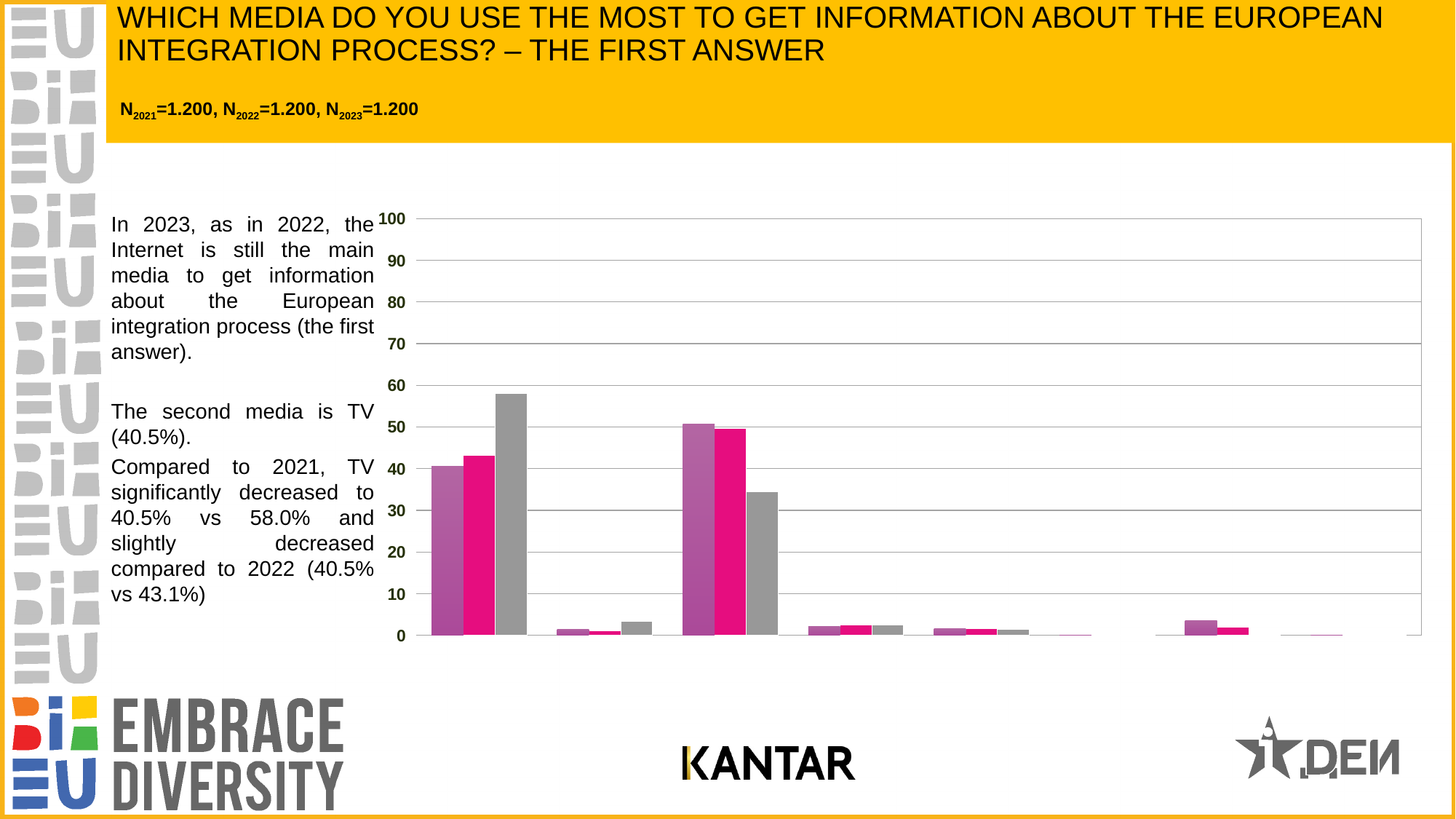
Which is taller: the grey bar in the first group or the grey bar in the third group? the grey bar in the first group In the third group of bars, is the grey bar greater or less than 40? less What kind of chart is shown on the slide? bar chart What is the highest value shown on the vertical axis of the chart? 100 In the first (leftmost) group of bars, is the grey bar greater or less than 50? greater What is the interval between consecutive tick labels on the vertical axis? 10 In the first (leftmost) group of bars, is the pink bar greater or less than 40? greater In the third group of bars, which bar is the shortest: purple, pink or grey? grey In the first (leftmost) group of bars, which bar is the tallest: purple, pink or grey? grey How many bars are in the first (leftmost) group of bars in the chart? 3